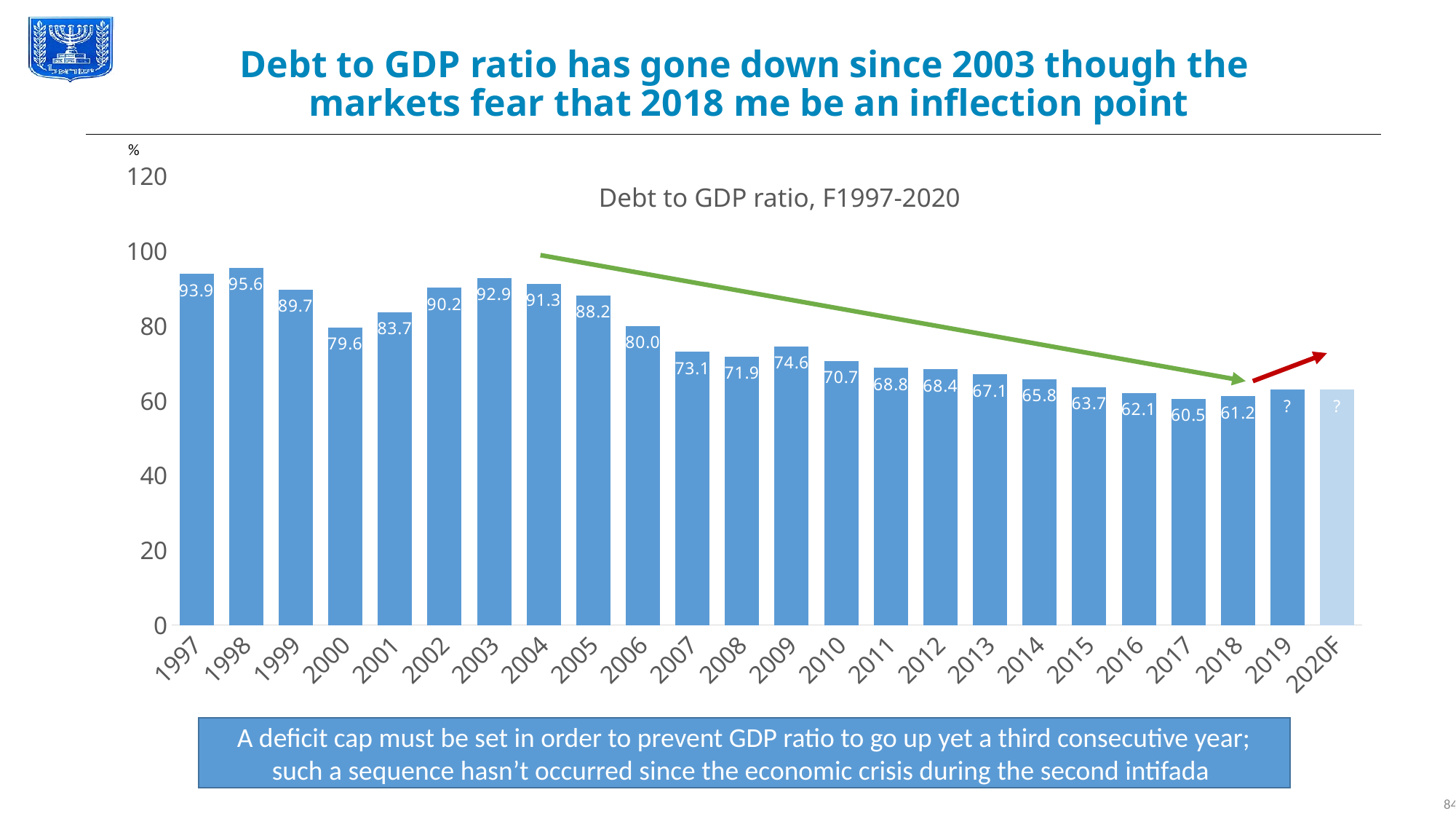
What is the debt to GDP ratio for 1998? 95.6 Which year has the lowest labelled debt to GDP ratio? 2017 Which year has the highest debt to GDP ratio? 1998 By how much did the debt to GDP ratio rise from 2017 to 2018? 0.7 What is the difference between the debt to GDP ratio in 1998 and in 2017? 35.1 What kind of chart is shown on the slide? bar chart Which year has a higher debt to GDP ratio, 2008 or 2009? 2009 What is the debt to GDP ratio for 2009? 74.6 What is the debt to GDP ratio for 2017? 60.5 Is the value for 2019 greater or less than 60? greater How many years are shown on the x axis of the chart? 24 Does the debt to GDP ratio rise or fall from 2003 to 2017? fall